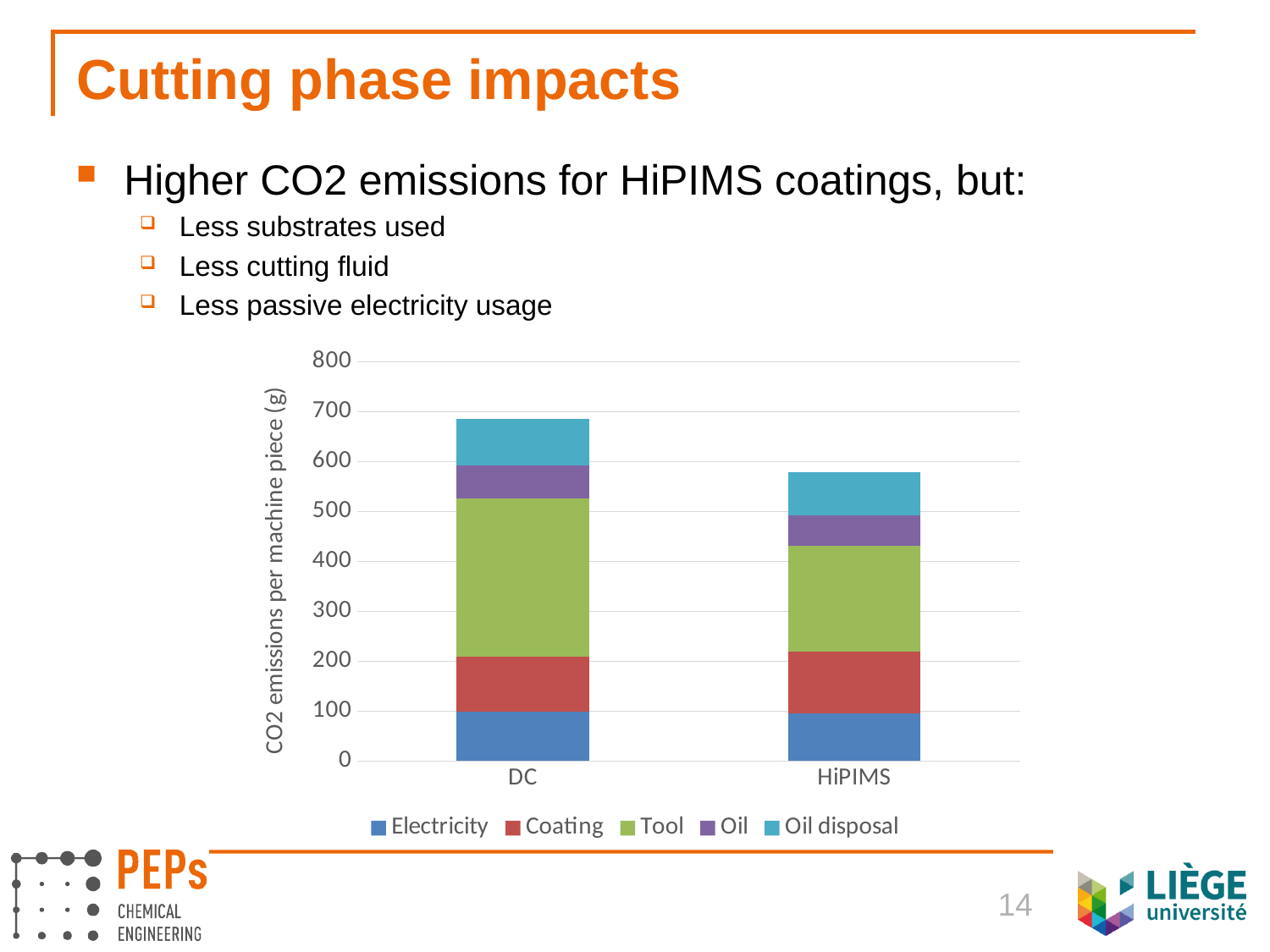
Is the total CO2 emissions value for DC greater or less than 700? less Is the total CO2 emissions value for HiPIMS greater or less than 600? less Which category has the larger Tool segment, DC or HiPIMS? DC How many categories are shown on the x axis of the chart? 2 Which category has the lowest total bar in the chart? HiPIMS What is the label of the chart's vertical axis? CO2 emissions per machine piece (g) Which category has the higher total CO2 emissions per machine piece, DC or HiPIMS? DC What kind of chart is shown on the slide? Stacked bar chart Is the total CO2 emissions value for DC greater or less than 600? greater How many series does the chart's legend list? 5 Which series is listed last in the chart's legend? Oil disposal